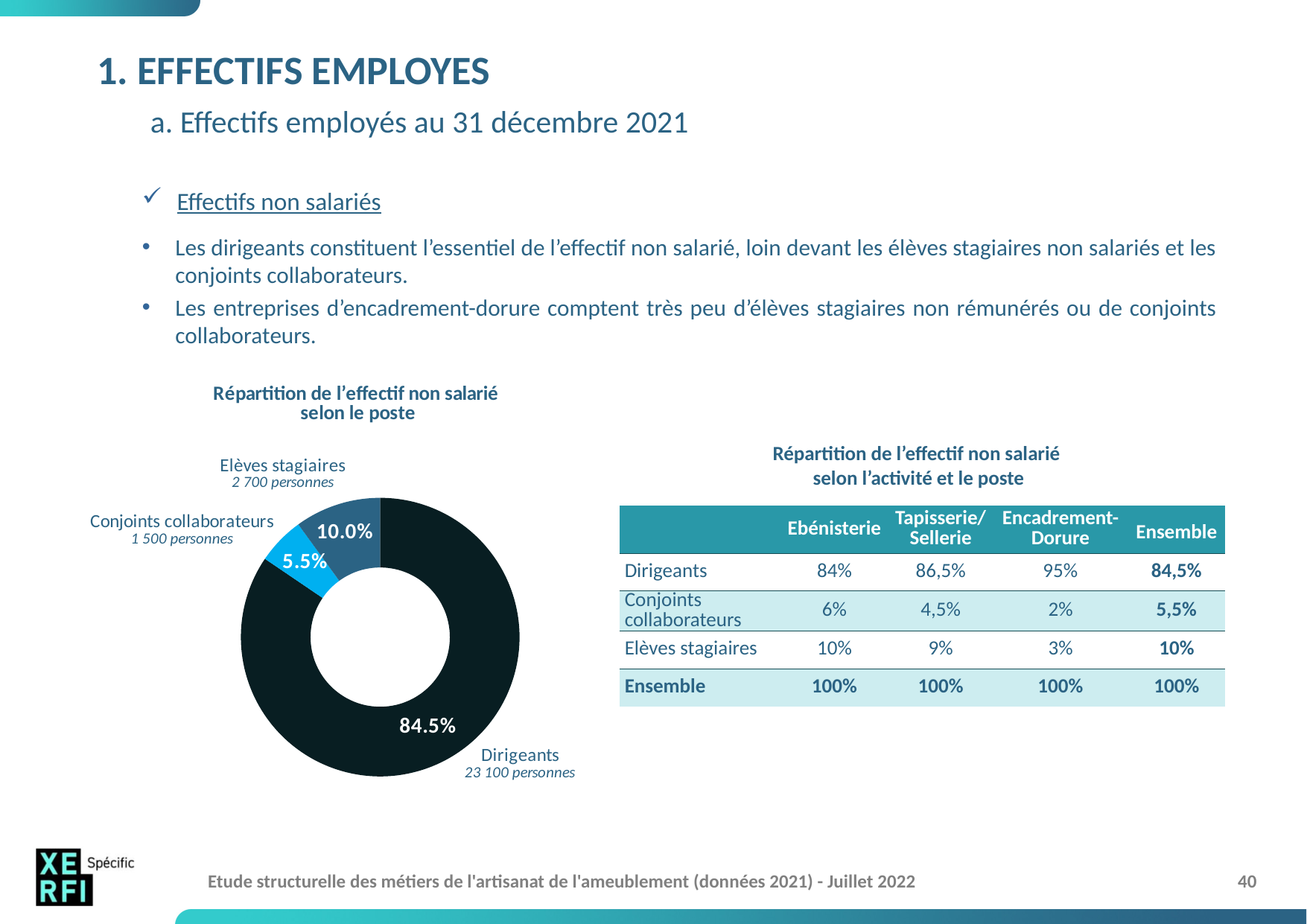
Which category has the smallest slice in the chart? Conjoints collaborateurs What share of the non-salaried workforce do Dirigeants represent in the chart? 84.5% How many people are indicated for Elèves stagiaires in the chart? 2 700 personnes What kind of chart is shown on the slide? Donut (pie) chart Which category has the largest slice in the chart? Dirigeants What is the title of the chart? Répartition de l'effectif non salarié selon le poste How many people are indicated for Dirigeants in the chart? 23 100 personnes What percentage is shown for Conjoints collaborateurs in the chart? 5.5% How many categories are shown in the chart? 3 How many people are indicated for Conjoints collaborateurs in the chart? 1 500 personnes What is the difference in percentage points between Elèves stagiaires and Conjoints collaborateurs in the chart? 4.5 percentage points What share of the chart is taken by Elèves stagiaires? 10.0%